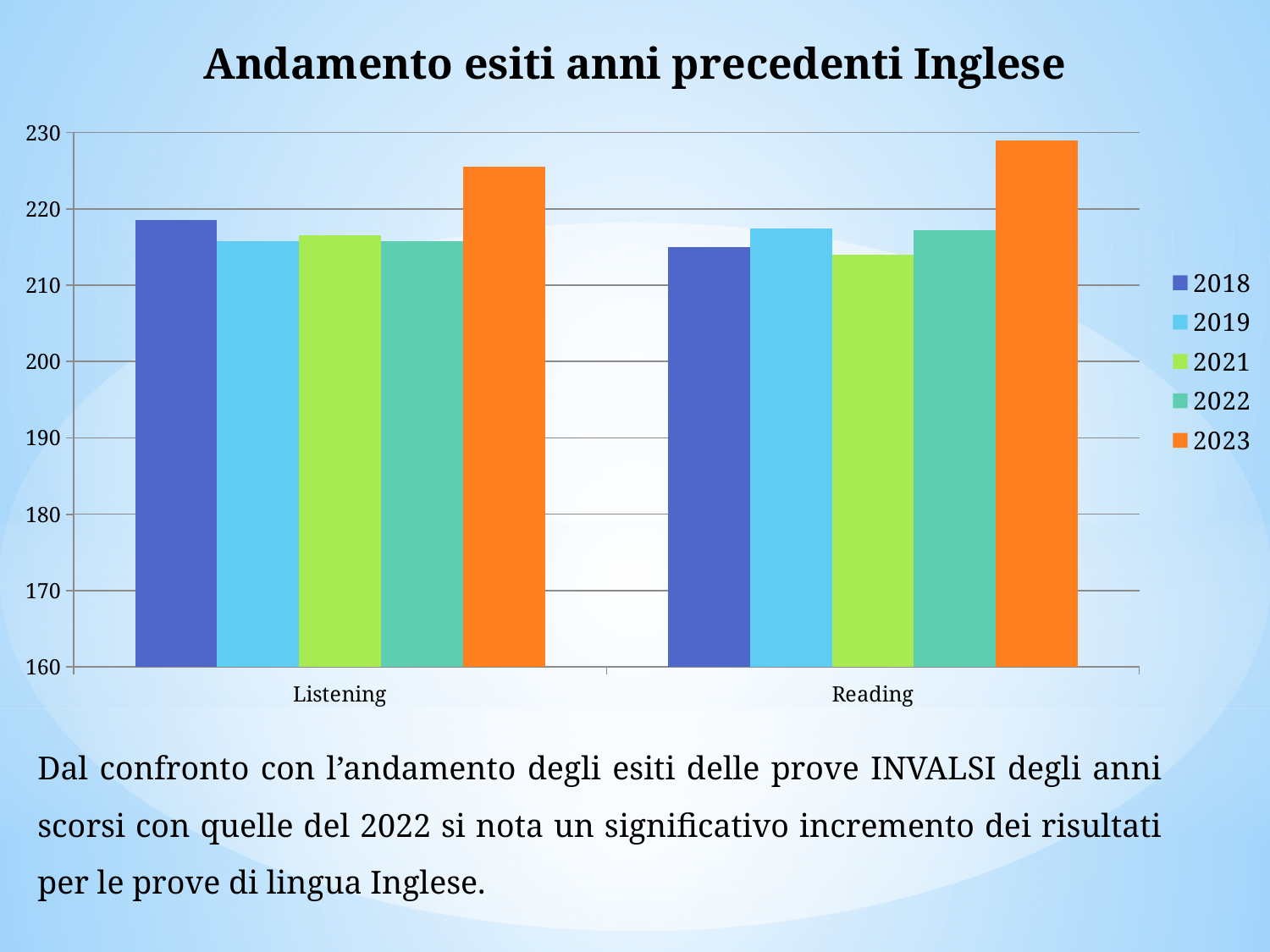
Which year has the highest value for Reading? 2023 Is the value for 2021 in Reading greater or less than 220? less Is the value for 2023 in Listening greater or less than 220? greater How many series does the legend list? 5 What is the title of the chart? Andamento esiti anni precedenti Inglese Which is larger: the 2023 value for Listening or the 2023 value for Reading? Reading Which year is shown in orange in the legend? 2023 Which year has the highest value for Listening? 2023 Is the value for 2018 in Listening greater or less than 210? greater Which is larger: the 2018 value for Listening or the 2018 value for Reading? Listening How many categories are shown on the x axis of the chart? 2 What kind of chart is shown on the slide? bar chart